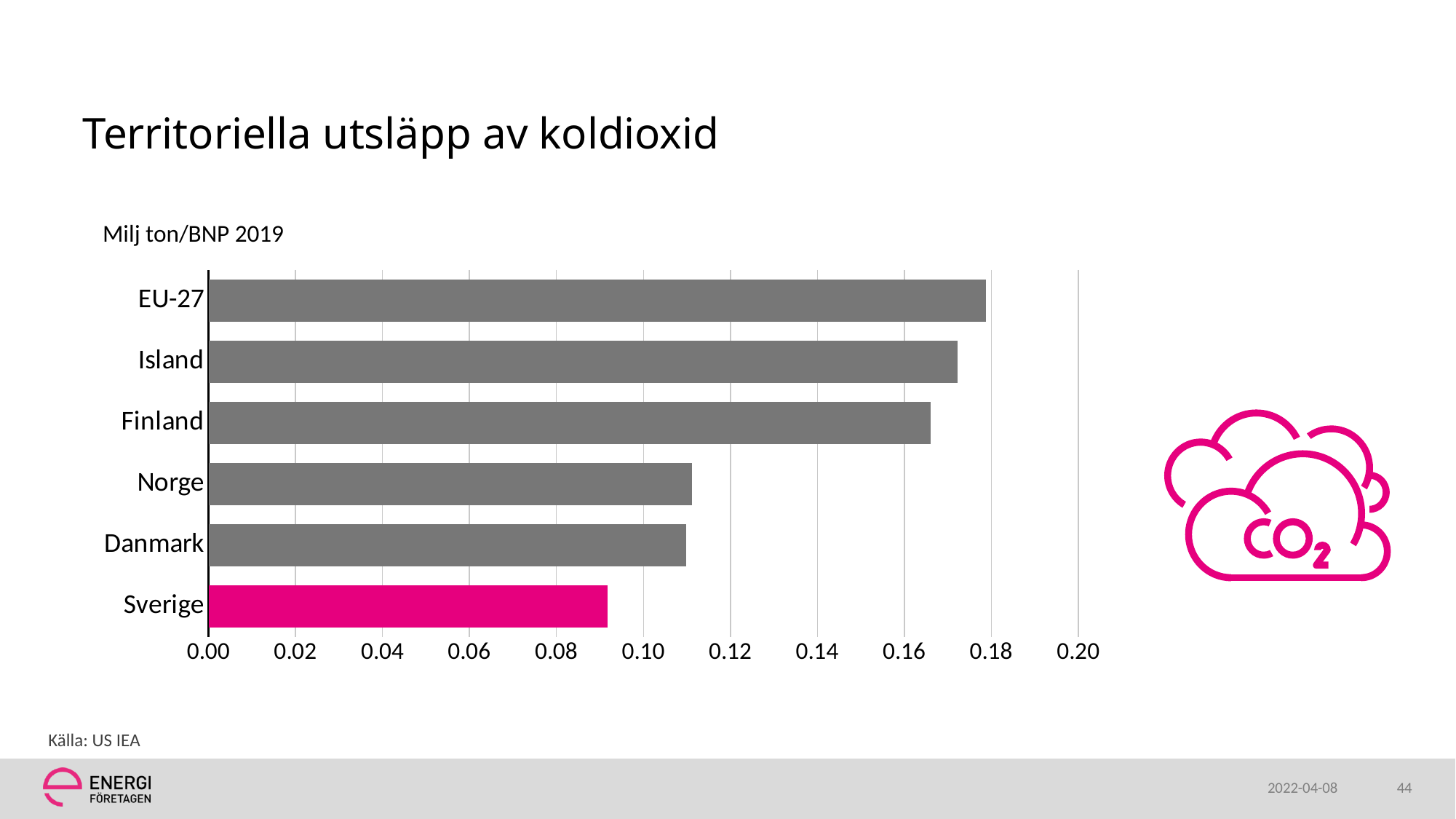
Is the value for Norge greater or less than 0.10? greater Which has a larger value, Finland or Norge? Finland Is the value for Finland greater or less than 0.16? greater Which category has the lowest value in the chart? Sverige Is the value for Danmark greater or less than 0.12? less How many countries or regions are shown in the chart? 6 Which category's bar is coloured pink instead of grey? Sverige Which category has the highest value in the chart? EU-27 What is the title of the slide's chart? Territoriella utsläpp av koldioxid What kind of chart is shown on the slide? bar chart